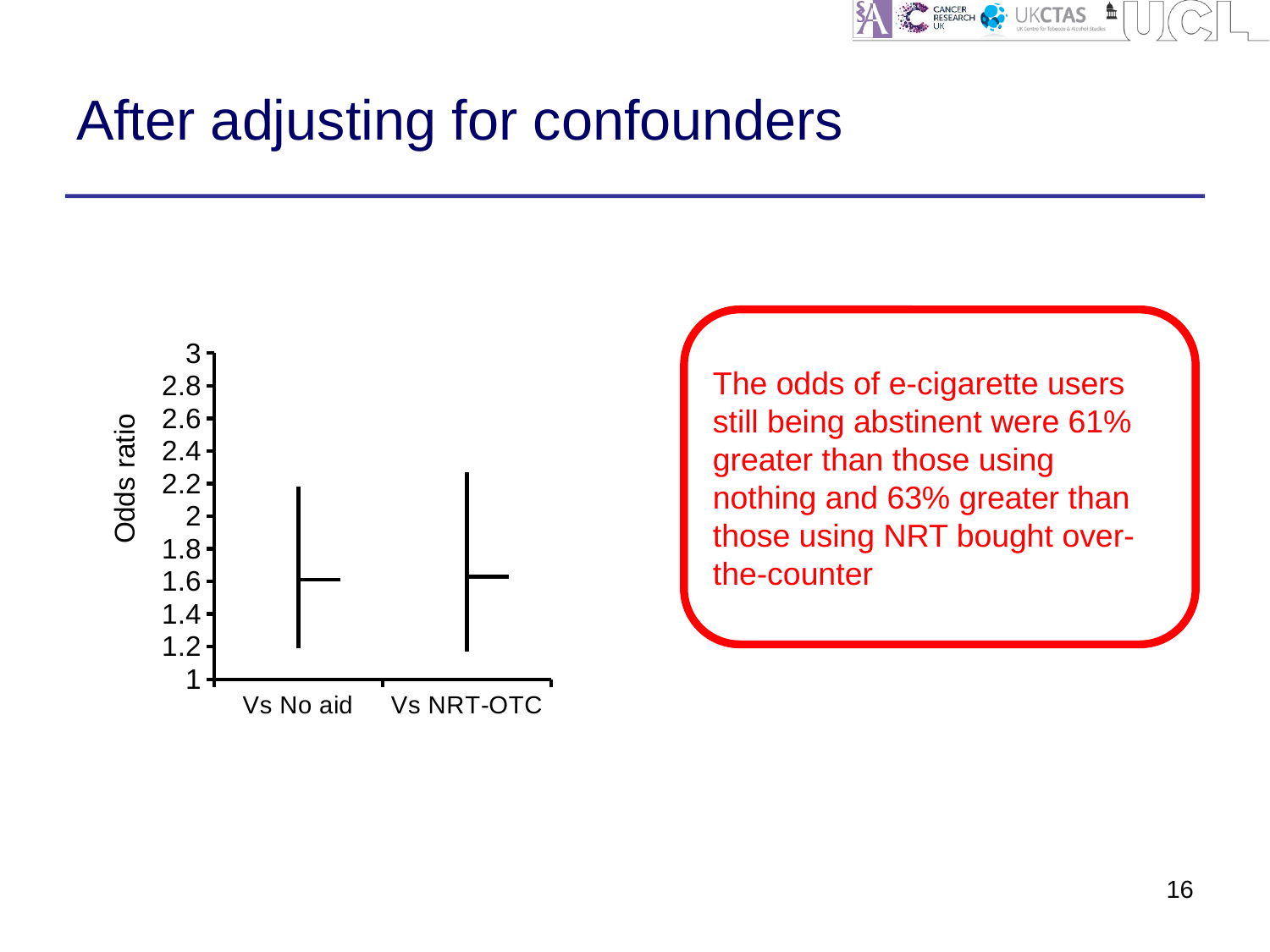
Is the odds ratio for Vs No aid greater or less than 1.4? greater What are the two category labels on the x axis of the chart? Vs No aid, Vs NRT-OTC What is the highest value shown on the y axis of the chart? 3 Is the odds ratio for Vs NRT-OTC greater or less than 1.4? greater How many categories are shown on the x axis of the chart? 2 Is the upper end of the error bar for Vs NRT-OTC greater or less than 2? greater What is the label of the y axis of the chart? Odds ratio What kind of chart is shown on the slide? error bar chart